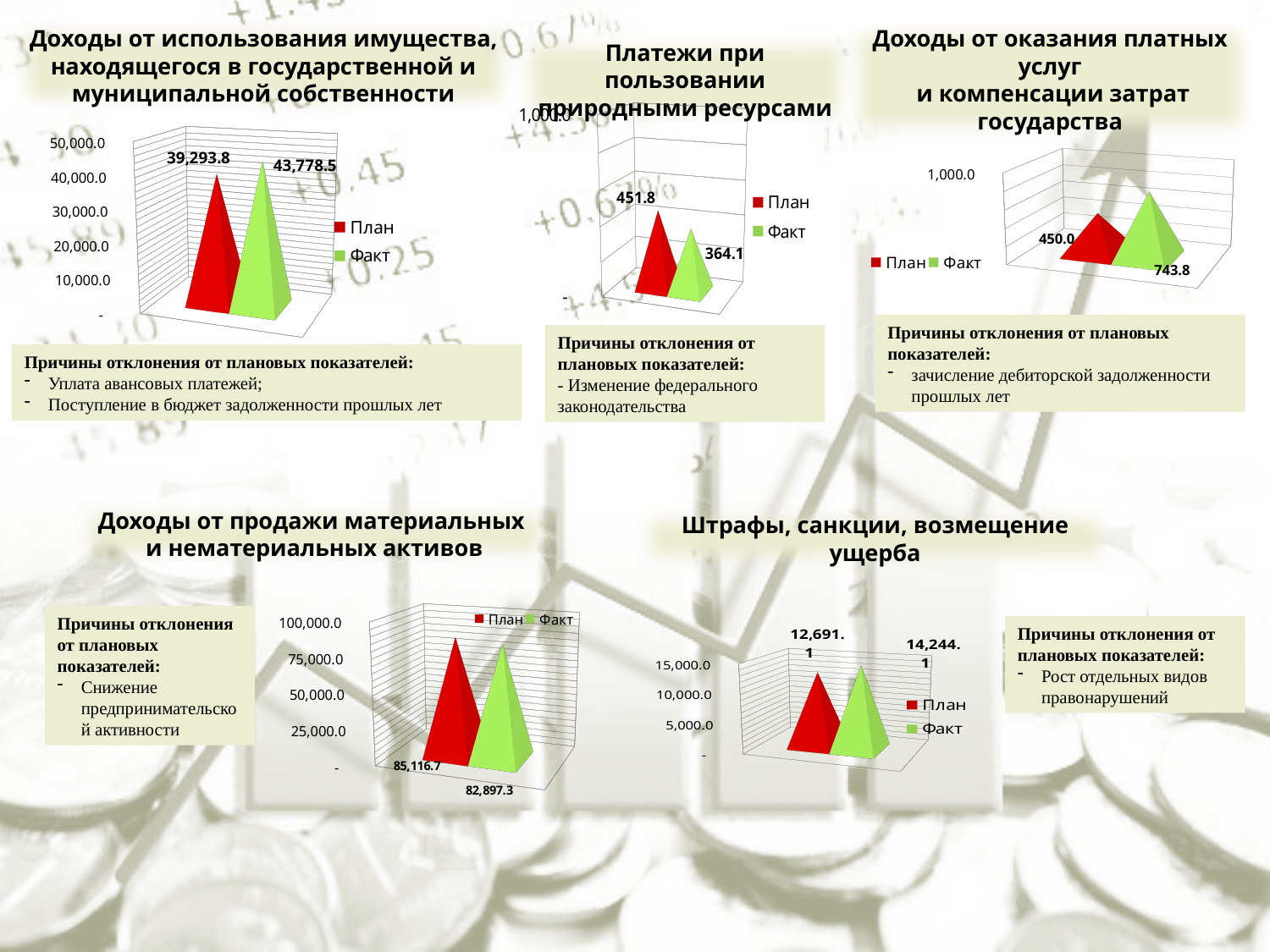
On the chart 'Платежи при пользовании природными ресурсами', what is the value for План? 451.8 On the chart 'Штрафы, санкции, возмещение ущерба', what is the value for Факт? 14,244.1 On the chart 'Платежи при пользовании природными ресурсами', which is larger, План or Факт? План On the chart 'Доходы от использования имущества, находящегося в государственной и муниципальной собственности', what is the value for Факт? 43,778.5 On the chart 'Доходы от использования имущества, находящегося в государственной и муниципальной собственности', what is the value for План? 39,293.8 On the chart 'Доходы от оказания платных услуг и компенсации затрат государства', what is the difference between Факт and План? 293.8 On the chart 'Доходы от продажи материальных и нематериальных активов', is the value for Факт greater or less than 75,000.0? greater On the chart 'Доходы от оказания платных услуг и компенсации затрат государства', what is the value for Факт? 743.8 On the chart 'Штрафы, санкции, возмещение ущерба', how many series does the legend list? 2 On the chart 'Доходы от продажи материальных и нематериальных активов', what is the value for План? 85,116.7 On the chart 'Доходы от использования имущества, находящегося в государственной и муниципальной собственности', what is the difference between Факт and План? 4,484.7 What kind of chart is 'Штрафы, санкции, возмещение ущерба'? Bar chart